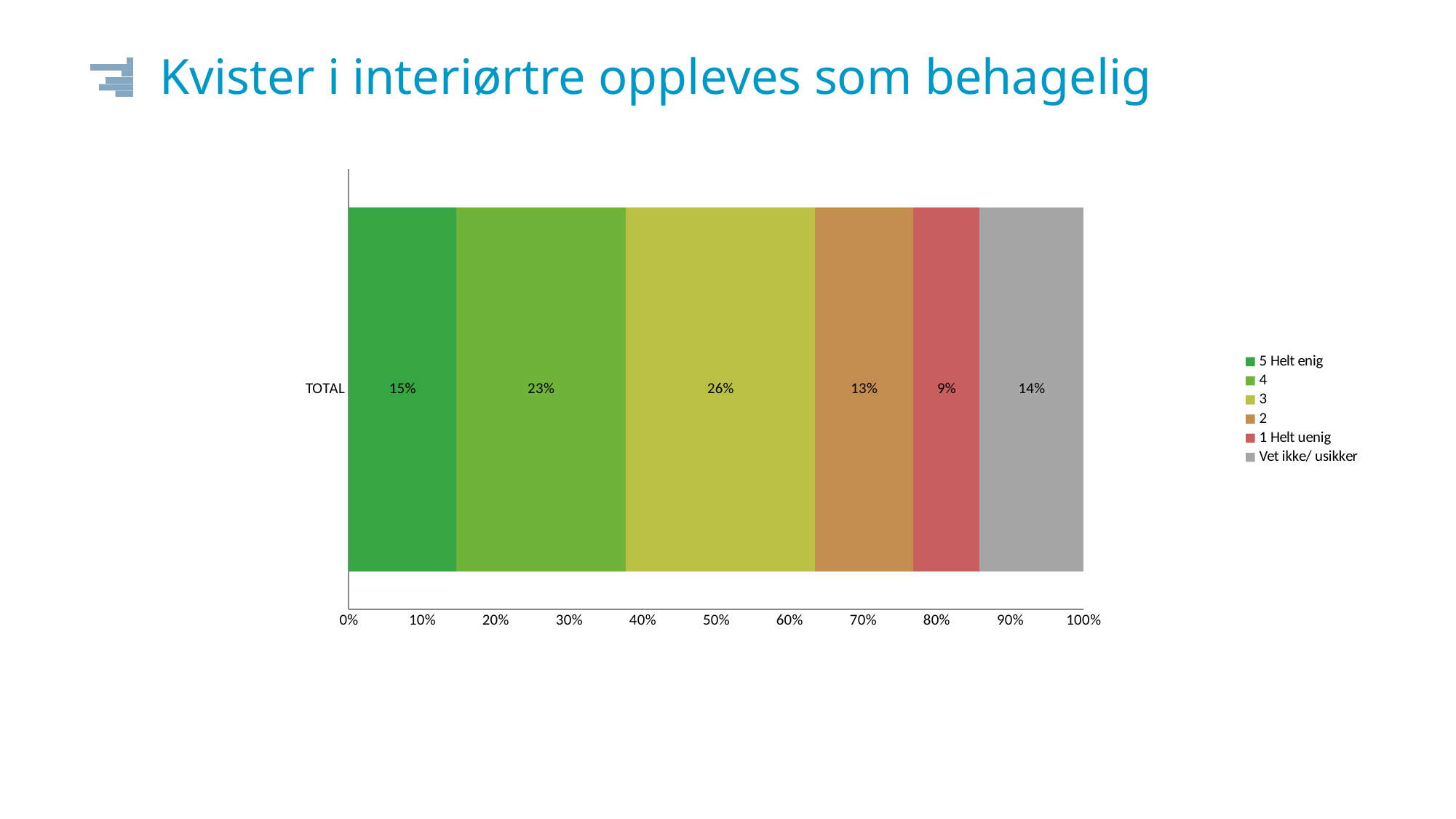
What is the label of the single category on the vertical axis? TOTAL What is the value for the "3" segment of the TOTAL bar? 26% Which response category has the smallest share of the TOTAL bar? 1 Helt uenig How many series does the legend list? 6 What is the combined share of "5 Helt enig" and "4"? 38% What is the value for "1 Helt uenig"? 9% What share of respondents answered "Vet ikke/ usikker"? 14% Which response category has the largest share of the TOTAL bar? 3 What is the difference between the "4" segment and the "2" segment? 10% Which is larger, the "5 Helt enig" segment or the "Vet ikke/ usikker" segment? 5 Helt enig What percentage of respondents answered "5 Helt enig"? 15% What kind of chart is shown on the slide? Stacked bar chart